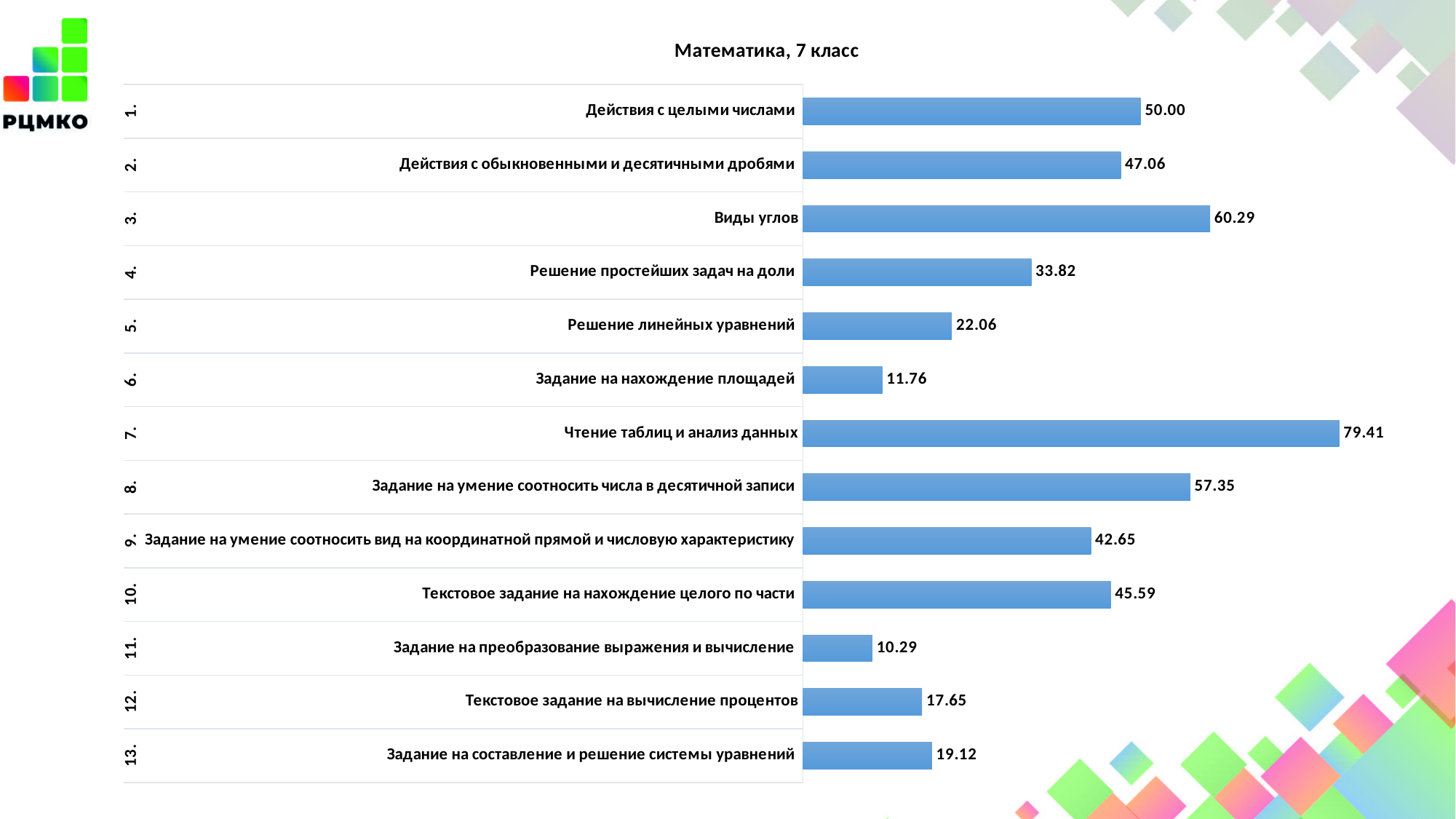
What is the value for "Действия с целыми числами"? 50.00 How many categories are shown in the chart? 13 Which category has the lowest value? Задание на преобразование выражения и вычисление What is the difference between the values for "Чтение таблиц и анализ данных" and "Задание на умение соотносить числа в десятичной записи"? 22.06 What is the value for "Задание на умение соотносить числа в десятичной записи"? 57.35 What is the value for "Виды углов"? 60.29 What kind of chart is shown on the slide? Bar chart Which is larger: the value for "Решение простейших задач на доли" or the value for "Решение линейных уравнений"? Решение простейших задач на доли Which category has the highest value? Чтение таблиц и анализ данных What is the difference between the values for "Виды углов" and "Действия с целыми числами"? 10.29 What is the title of the chart? Математика, 7 класс What is the value for "Текстовое задание на вычисление процентов"? 17.65